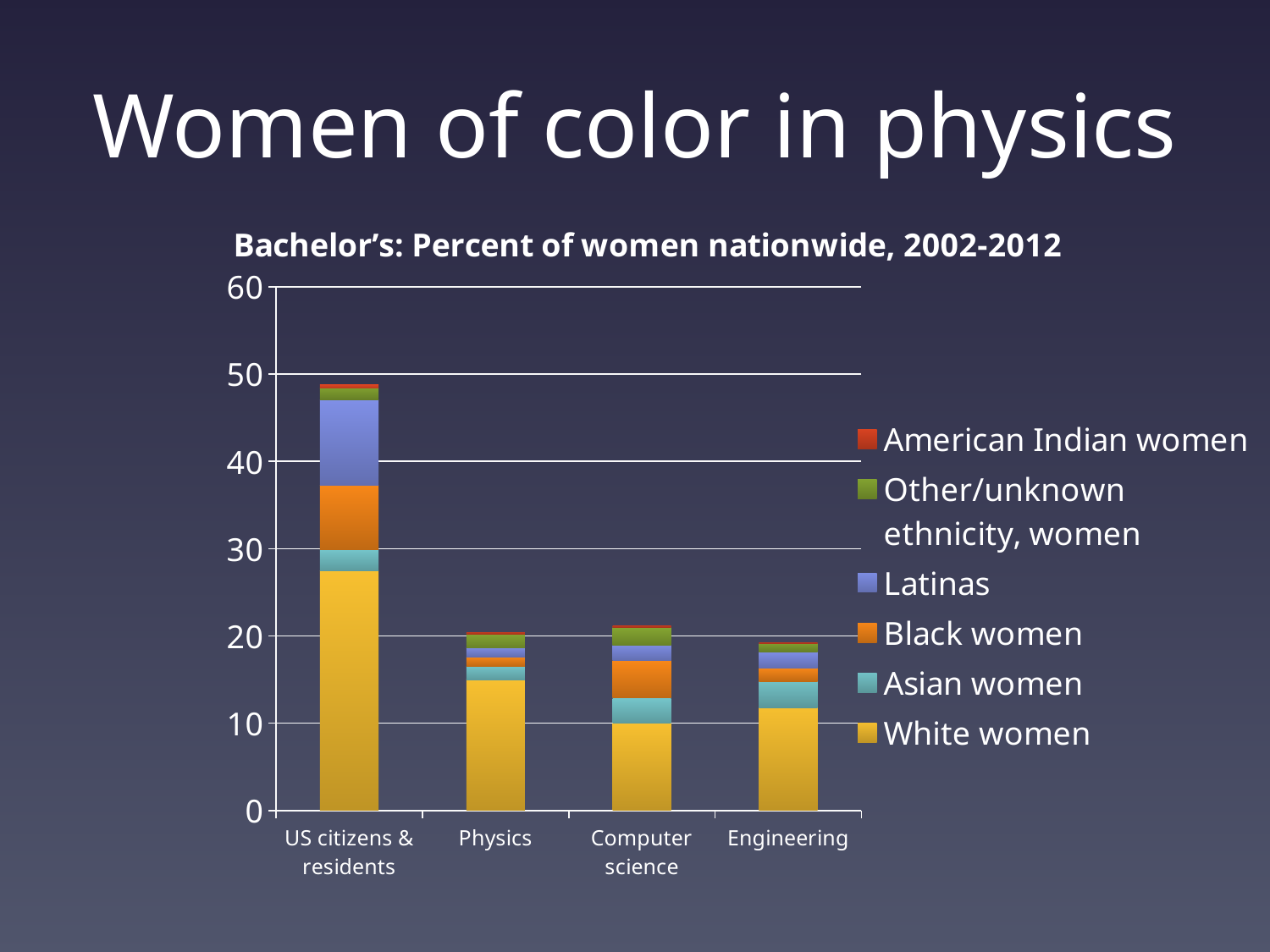
Is the White women segment for Physics greater or less than 20? less Is the total stacked value for Physics greater or less than 30? less Is the total stacked value for US citizens & residents greater or less than 40? greater What kind of chart is shown on the slide? Stacked bar chart How many series does the legend list? 6 Which category has the tallest stacked bar? US citizens & residents What is the title of the chart? Bachelor's: Percent of women nationwide, 2002-2012 Which has a larger total stacked value, US citizens & residents or Engineering? US citizens & residents Which series is shown at the bottom of each stacked bar? White women How many categories are shown along the x axis? 4